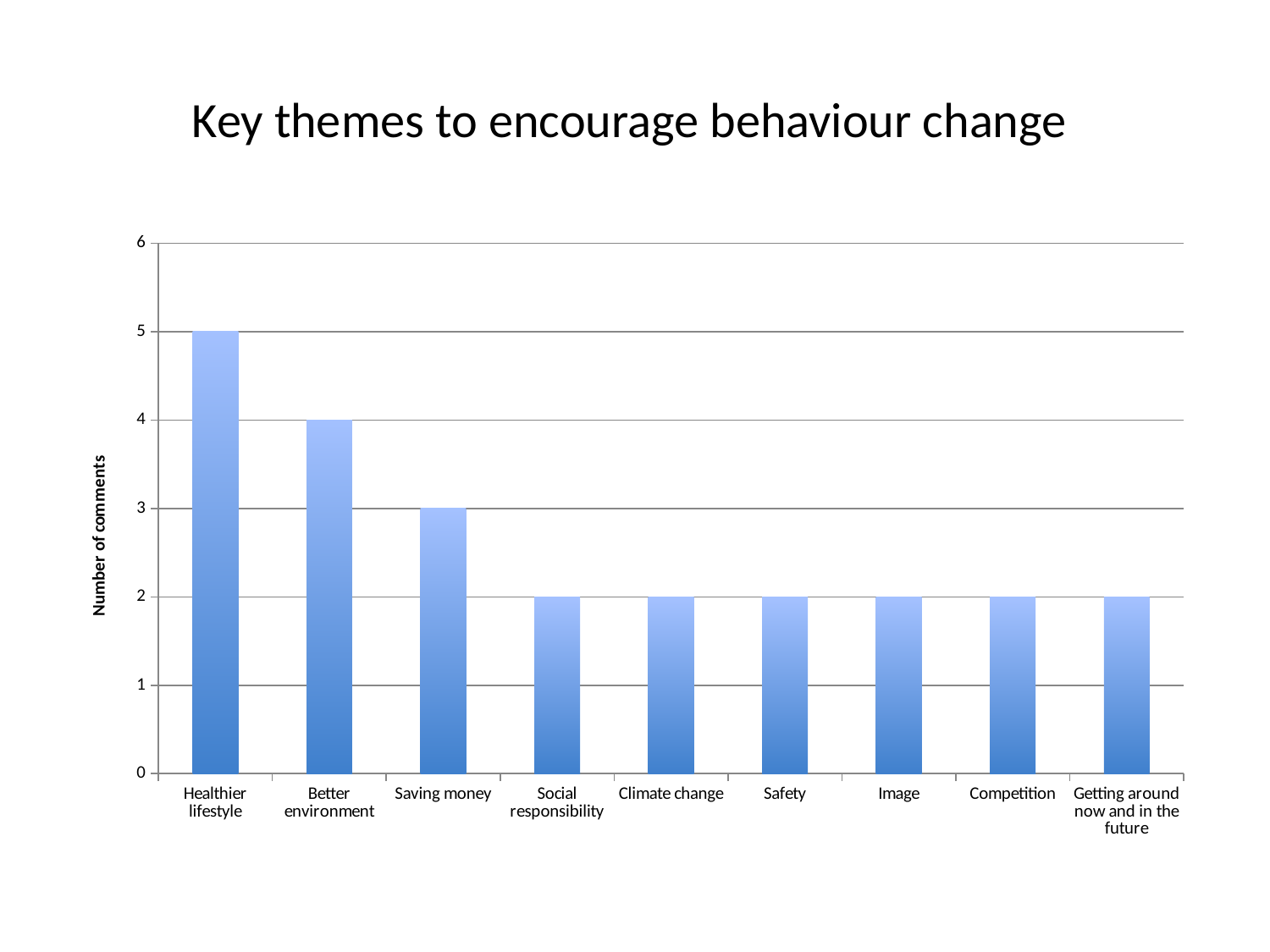
What is the label of the vertical axis? Number of comments How many themes are shown on the x axis? 9 What is the number of comments for Healthier lifestyle? 5 What is the number of comments for Saving money? 3 Which theme has the highest number of comments? Healthier lifestyle What is the number of comments for Better environment? 4 What is the number of comments for Climate change? 2 Is the value for Healthier lifestyle greater or less than 4? greater What kind of chart is shown on the slide? Bar chart Do the values rise or fall from Healthier lifestyle to Saving money? Fall What is the difference in number of comments between Healthier lifestyle and Saving money? 2 Which has more comments, Better environment or Safety? Better environment